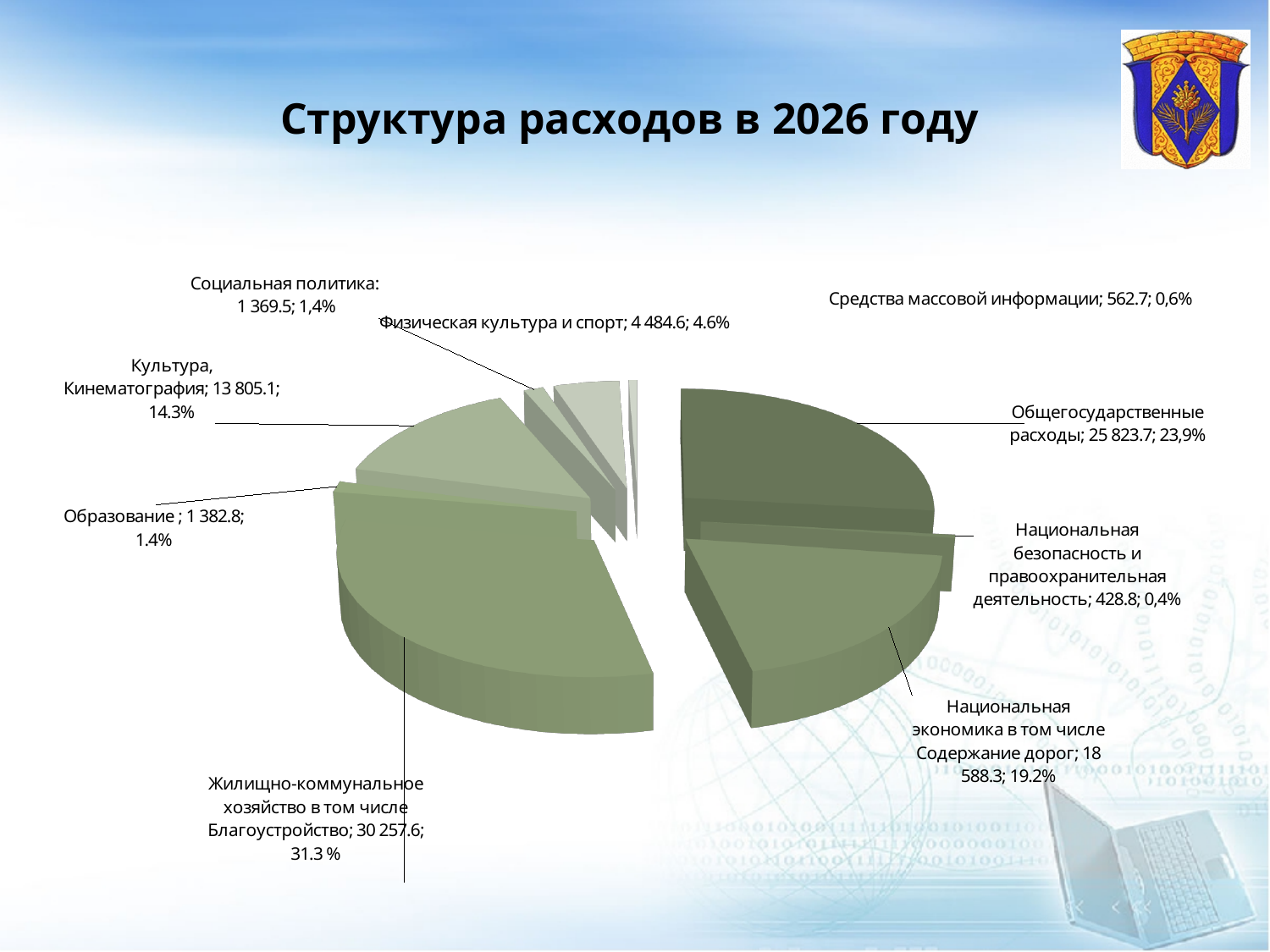
Which category has the smallest share of the pie? Национальная безопасность и правоохранительная деятельность What kind of chart is shown on the slide? Pie chart Which category has the largest share of the pie? Жилищно-коммунальное хозяйство в том числе Благоустройство What share of the pie does Жилищно-коммунальное хозяйство в том числе Благоустройство have? 31.3 % Which is larger: Общегосударственные расходы or Национальная экономика в том числе Содержание дорог? Общегосударственные расходы What percentage is shown for Культура, Кинематография? 14.3% What is the title of the chart? Структура расходов в 2026 году What value is shown for Общегосударственные расходы? 25 823.7 What value is shown for Средства массовой информации? 562.7 How many categories (slices) does the pie chart have? 9 What percentage is shown for Физическая культура и спорт? 4.6% What is the difference between the values for Общегосударственные расходы and Национальная экономика в том числе Содержание дорог? 7 235.4